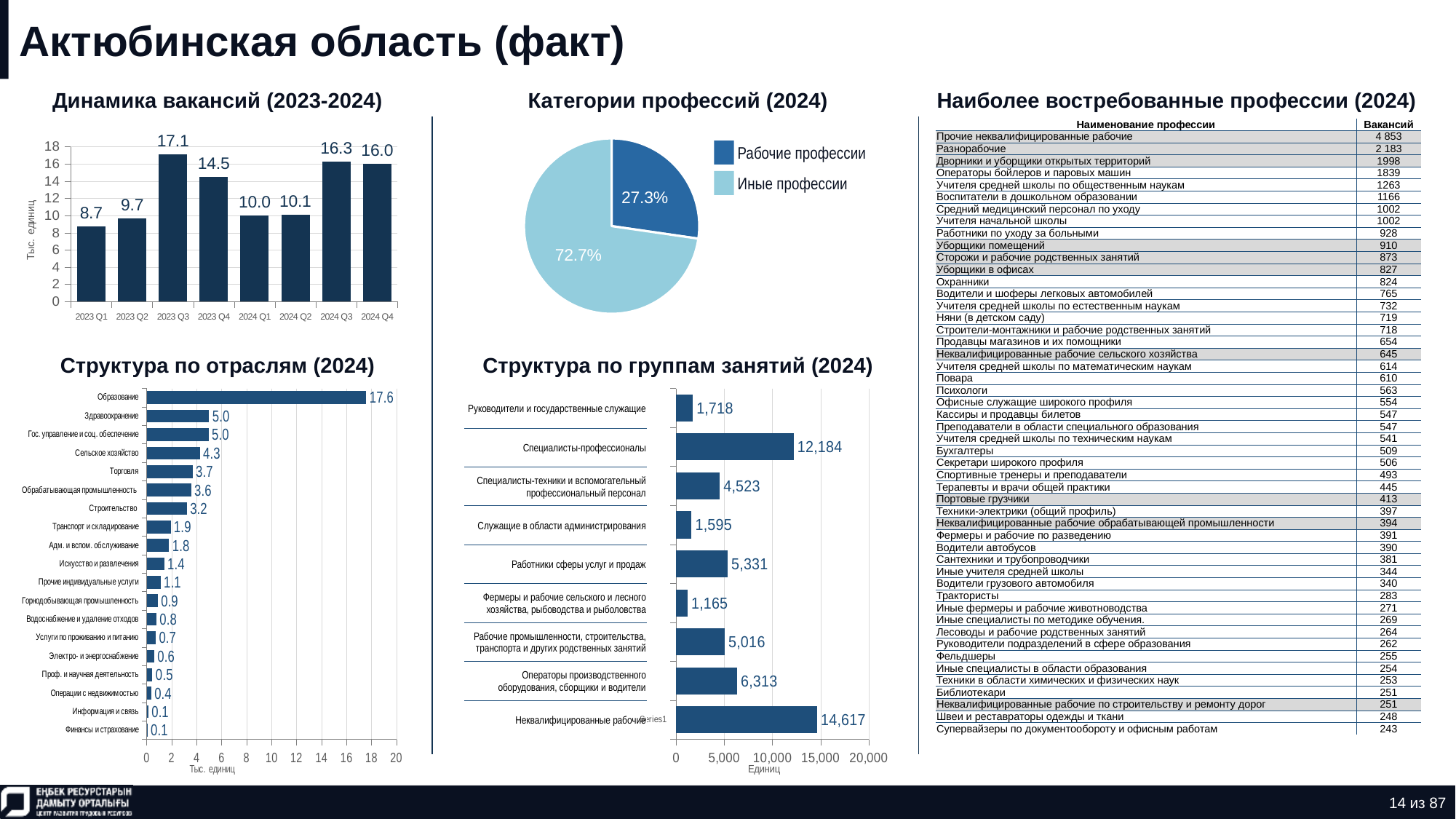
In the chart 'Категории профессий (2024)', what share of the pie is 'Рабочие профессии'? 27.3% What kind of chart is 'Категории профессий (2024)'? pie chart In the chart 'Структура по отраслям (2024)', which is larger: 'Торговля' or 'Строительство'? Торговля In the chart 'Динамика вакансий (2023-2024)', what is the value for 2023 Q3? 17.1 In the chart 'Категории профессий (2024)', how many entries does the legend list? 2 In the chart 'Структура по отраслям (2024)', which category has the highest value? Образование In the chart 'Динамика вакансий (2023-2024)', how many quarters are plotted? 8 In the chart 'Структура по группам занятий (2024)', what is the value for 'Специалисты-профессионалы'? 12,184 In the chart 'Динамика вакансий (2023-2024)', what is the difference between 2024 Q3 and 2024 Q4? 0.3 In the chart 'Динамика вакансий (2023-2024)', which quarter has the lowest value? 2023 Q1 In the chart 'Структура по отраслям (2024)', what is the value for 'Образование'? 17.6 In the chart 'Структура по группам занятий (2024)', which category has the lowest value? Фермеры и рабочие сельского и лесного хозяйства, рыбоводства и рыболовства